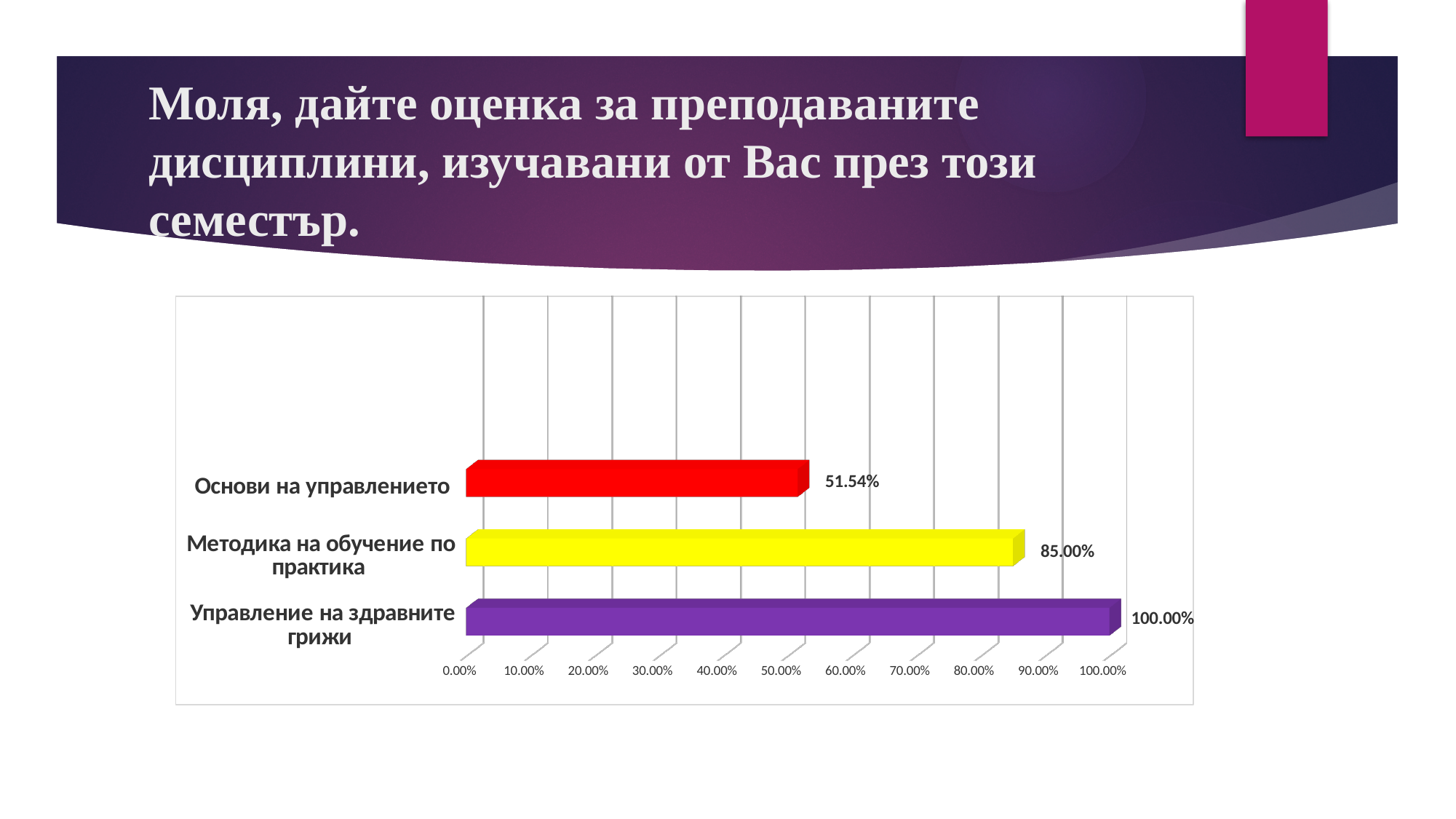
Is the value for Основи на управлението greater or less than 60.00%? less What is the value for Основи на управлението? 51.54% How many categories are shown in the chart? 3 Which category has the lowest value? Основи на управлението Which category has the highest value? Управление на здравните грижи What is the difference between the values for Управление на здравните грижи and Методика на обучение по практика? 15.00% What is the value for Методика на обучение по практика? 85.00% What kind of chart is shown on the slide? bar chart What is the difference between the values for Методика на обучение по практика and Основи на управлението? 33.46% Which is larger, the value for Основи на управлението or the value for Методика на обучение по практика? Методика на обучение по практика What is the value for Управление на здравните грижи? 100.00% What colour is the bar for Методика на обучение по практика? yellow